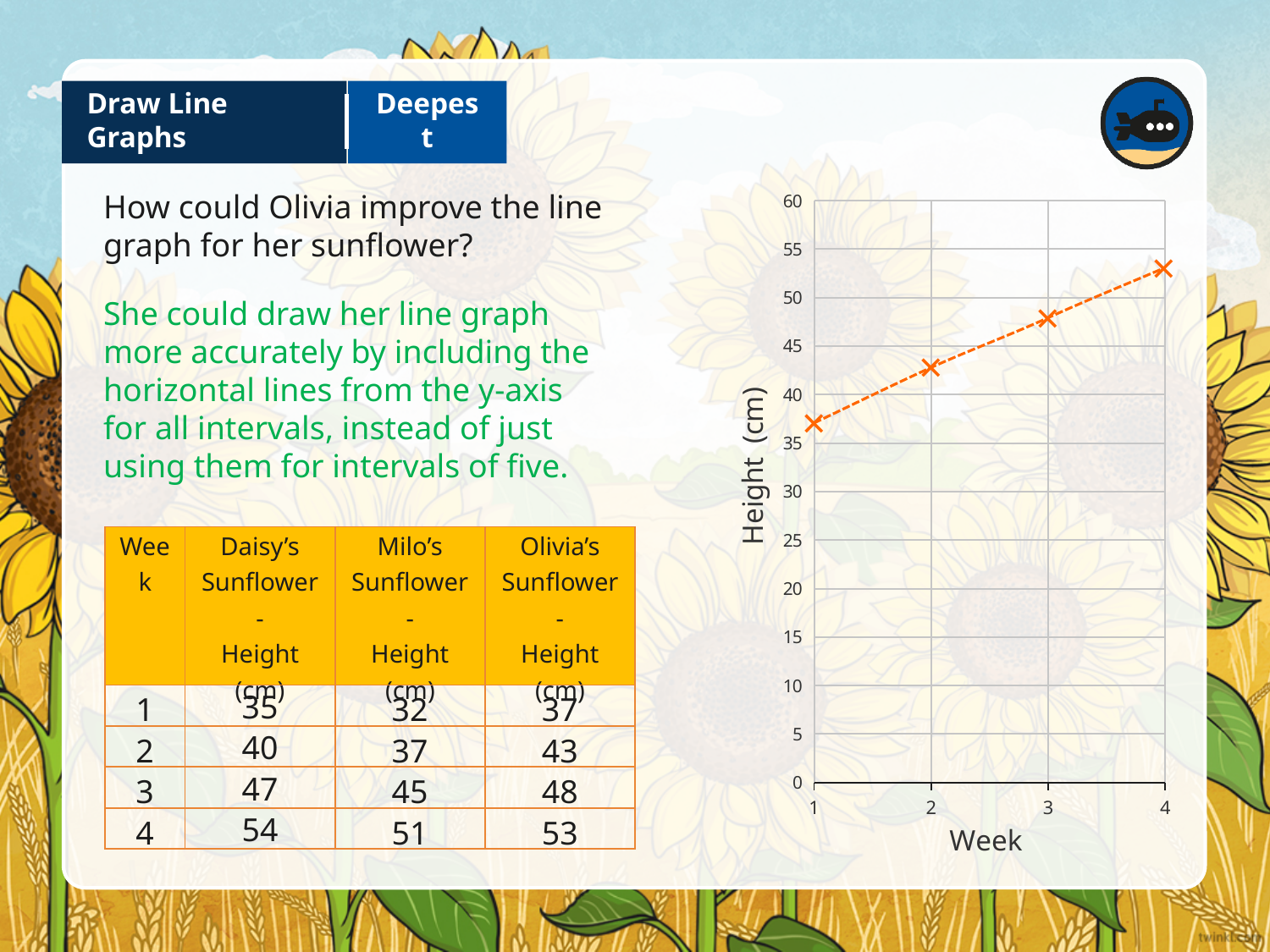
On the line chart, is the value for week 3 larger or smaller than the value for week 2? larger How many data points are plotted on the line chart? 4 Do the values on the line chart rise or fall from week 1 to week 4? rise Which week has the lowest value on the line chart? 1 Which week has the highest value on the line chart? 4 What is the label of the x-axis on the line chart? Week Is the value for week 3 on the line chart greater or less than 50? less Is the value for week 2 on the line chart greater or less than 45? less What kind of chart is shown on the slide? line chart Is the value for week 4 on the line chart greater or less than 50? greater What is the label of the y-axis on the line chart? Height (cm)